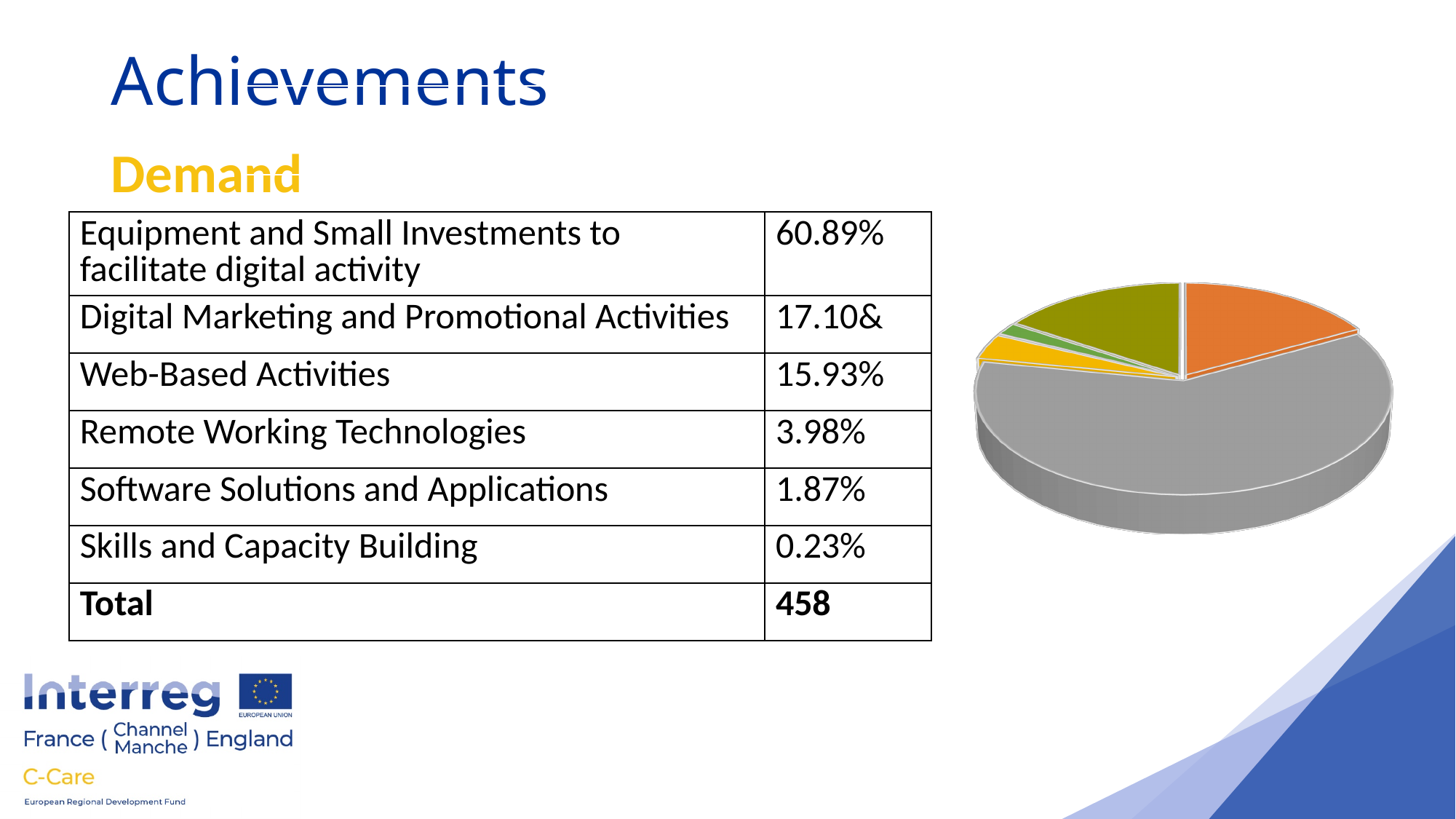
What kind of chart is shown on the right of the slide? pie chart What share is shown for Skills and Capacity Building? 0.23% What share is shown for Software Solutions and Applications? 1.87% What is the Total given in the Demand table? 458 What is the difference between the shares for Web-Based Activities and Remote Working Technologies? 11.95% Which category has the largest share of demand? Equipment and Small Investments to facilitate digital activity What share is shown for Web-Based Activities? 15.93% Which colour is the largest slice of the pie chart? gray How many demand categories are listed, excluding the Total row? 6 Which category has the smallest share of demand? Skills and Capacity Building According to the Demand table, what share is Equipment and Small Investments to facilitate digital activity? 60.89% What share is shown for Remote Working Technologies? 3.98%